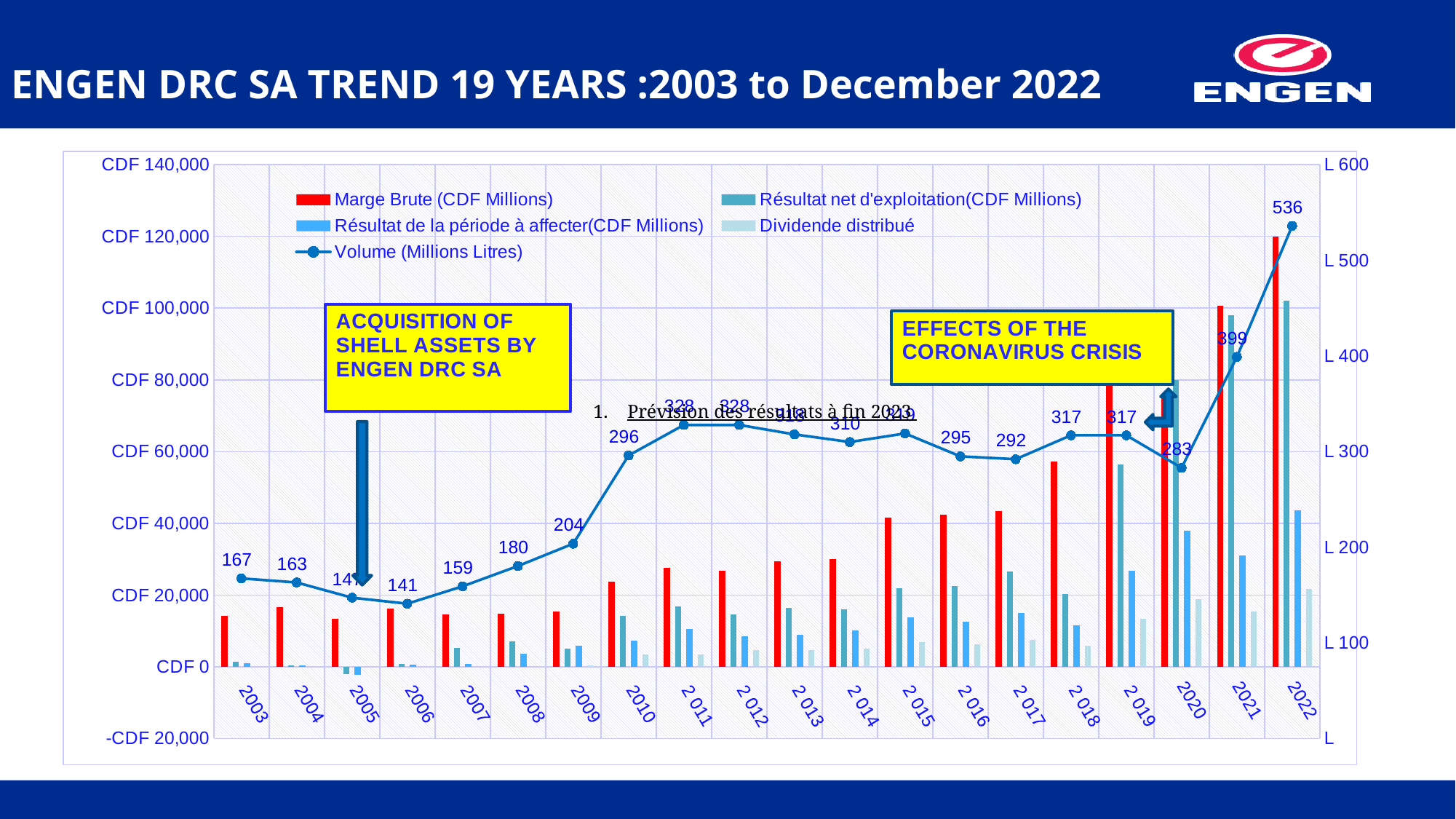
Is the Marge Brute (CDF Millions) value for 2022 greater or less than CDF 100,000? greater What is the difference in Volume (Millions Litres) between 2010 and 2009? 92 How many series does the chart legend list? 5 What is the Volume (Millions Litres) value for 2020? 283 Which year has the larger Volume (Millions Litres), 2019 or 2020? 2019 Does the Volume (Millions Litres) rise or fall from 2020 to 2022? rise In which year is the Volume (Millions Litres) highest? 2022 What is the Volume (Millions Litres) value for 2003? 167 What is the difference in Volume (Millions Litres) between 2022 and 2021? 137 Is the Marge Brute (CDF Millions) value for 2003 greater or less than CDF 20,000? less How many years are shown on the x axis of the chart? 20 What is the Volume (Millions Litres) value for 2022? 536